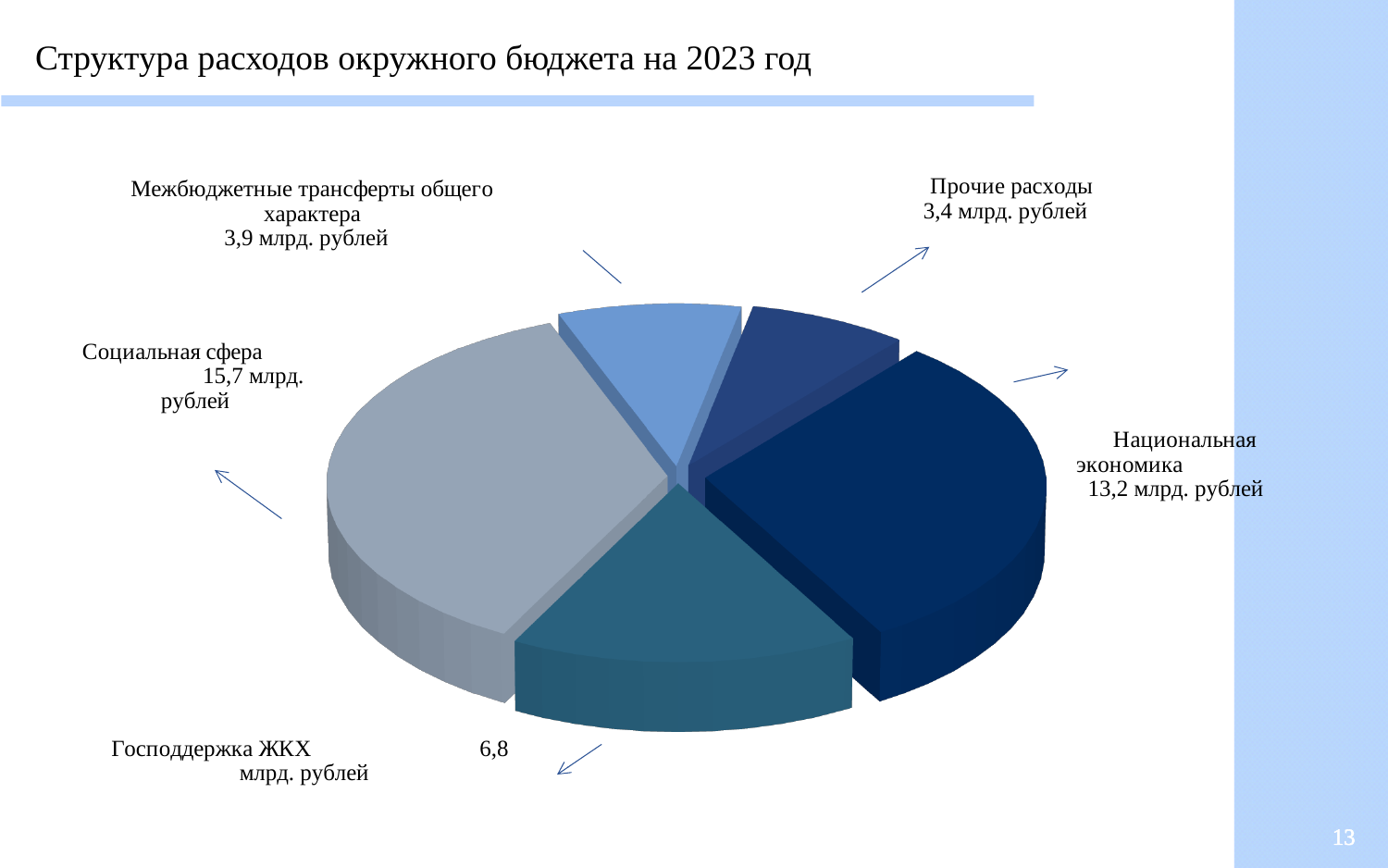
What is the difference between Социальная сфера and Национальная экономика? 2,5 млрд. рублей Which is larger, Господдержка ЖКХ or Межбюджетные трансферты общего характера? Господдержка ЖКХ What kind of chart is shown on the slide? Pie chart Which category has the largest share of expenditures? Социальная сфера What is the value for Господдержка ЖКХ? 6,8 млрд. рублей What is the value for Национальная экономика? 13,2 млрд. рублей Which category has the smallest share of expenditures? Прочие расходы What is the value for Межбюджетные трансферты общего характера? 3,9 млрд. рублей What is the value for Прочие расходы? 3,4 млрд. рублей What is the value for Социальная сфера? 15,7 млрд. рублей What is the title of the chart? Структура расходов окружного бюджета на 2023 год How many slices does the pie chart have? 5